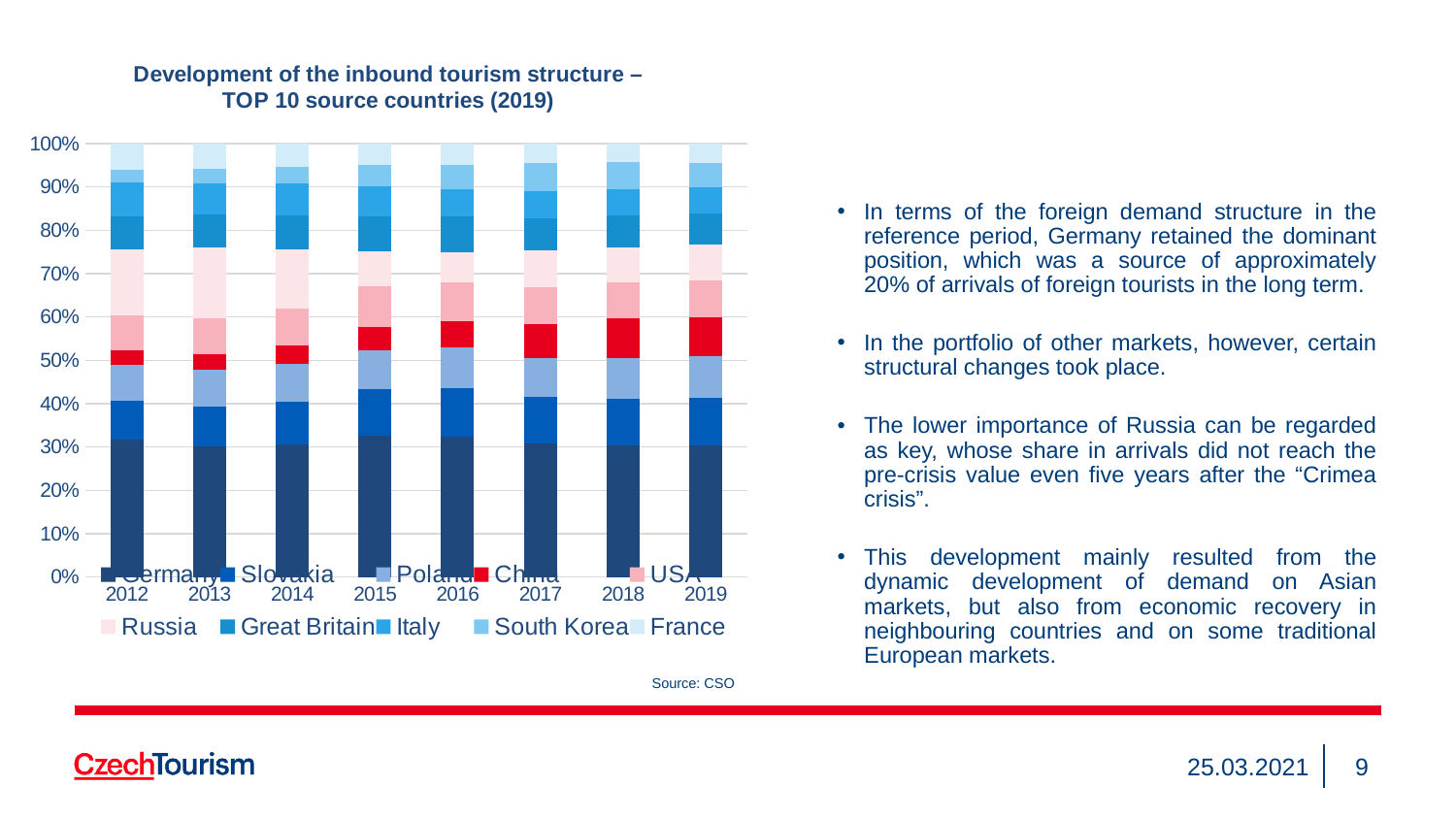
Is the share for China larger in 2012 or in 2019? 2019 Which country has the largest share of the 2019 bar? Germany Is the share for Russia larger in 2013 or in 2019? 2013 Does the share for Russia rise or fall from 2013 to 2019? fall Is the share for Germany in 2019 greater or less than 40%? less How many years are shown on the x axis of the chart? 8 Which country forms the bottom segment of each stacked bar? Germany How many source countries does the chart legend list? 10 What source is cited below the chart? CSO Is the share for Germany in 2012 greater or less than 20%? greater What kind of chart is shown on the slide? Stacked bar chart What is the title of the chart? Development of the inbound tourism structure – TOP 10 source countries (2019)